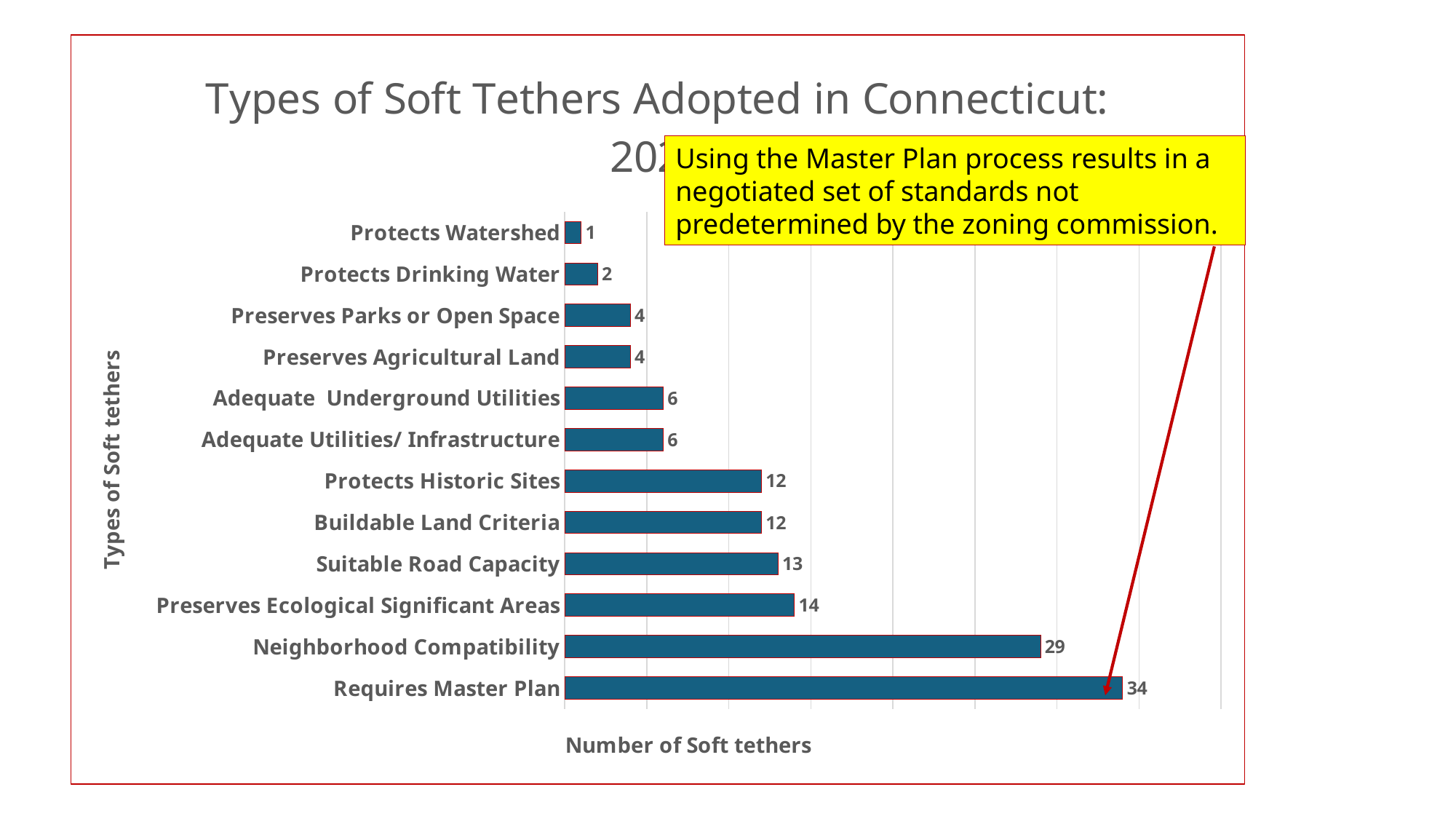
What kind of chart is shown on the slide? Bar chart Which category has the lowest value? Protects Watershed What is the value for Protects Watershed? 1 Which category has the highest value? Requires Master Plan What is the y-axis title of the chart? Types of Soft tethers What is the difference between Requires Master Plan and Neighborhood Compatibility? 5 What is the value for Requires Master Plan? 34 What is the x-axis title of the chart? Number of Soft tethers Which is larger, Suitable Road Capacity or Preserves Ecological Significant Areas? Preserves Ecological Significant Areas How many categories are shown in the chart? 12 What is the value for Neighborhood Compatibility? 29 What is the value for Protects Historic Sites? 12